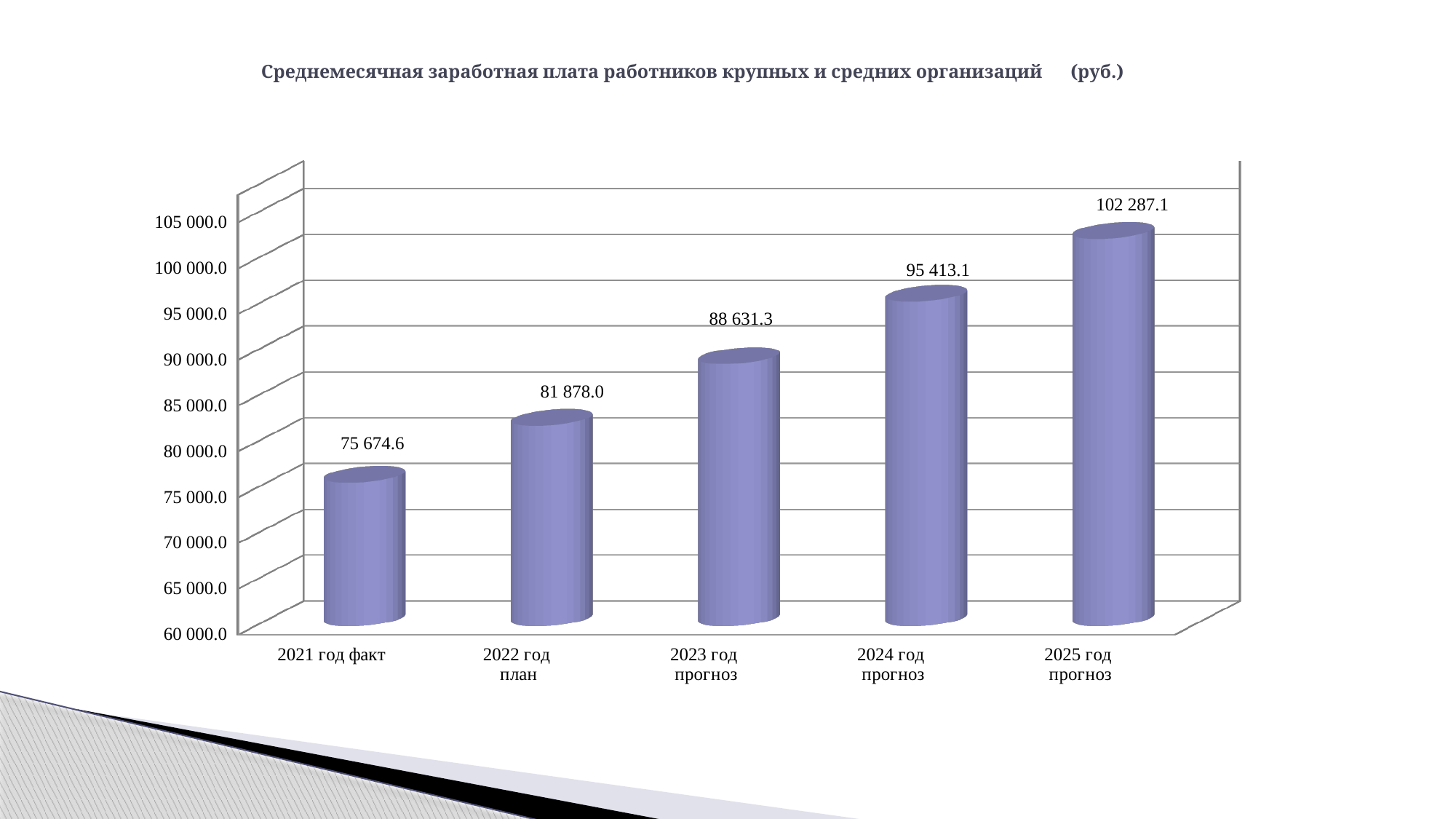
What is the value for 2023 год прогноз? 88 631.3 How many categories are shown on the x axis? 5 What is the value for 2025 год прогноз? 102 287.1 Do the values rise or fall from 2021 to 2025? rise What is the difference between the values for 2024 год прогноз and 2023 год прогноз? 6 781.8 Which is larger, the value for 2022 год план or the value for 2024 год прогноз? 2024 год прогноз Is the value for 2022 год план greater or less than 80 000.0? greater Which category has the highest value? 2025 год прогноз What is the difference between the values for 2025 год прогноз and 2021 год факт? 26 612.5 What is the value for 2021 год факт? 75 674.6 Which category has the lowest value? 2021 год факт What kind of chart is shown on the slide? bar chart